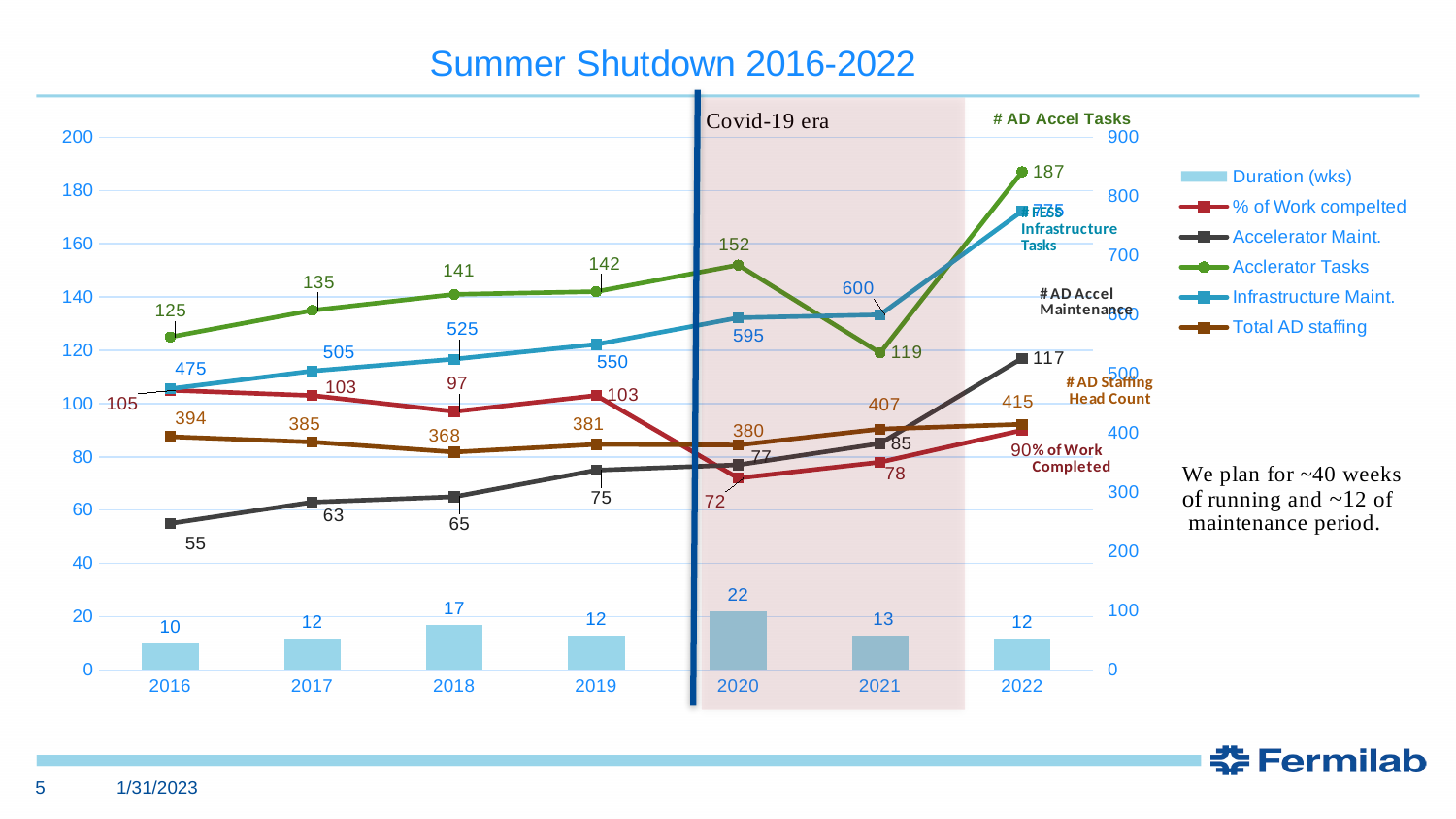
What is the Total AD staffing value for 2018? 368 What is the Duration (wks) value for 2020? 22 How many years are shown on the x axis? 7 What is the Infrastructure Maint. value for 2020? 595 How many series does the legend list? 6 What is the Accelerator Maint. value for 2016? 55 Which year has the lowest Total AD staffing value? 2018 Which year has the larger Duration (wks), 2018 or 2021? 2018 Which year has the lowest Acclerator Tasks value? 2021 What is the Acclerator Tasks value for 2022? 187 What is the difference between the Accelerator Maint. values for 2022 and 2021? 32 Which year has the highest Duration (wks)? 2020